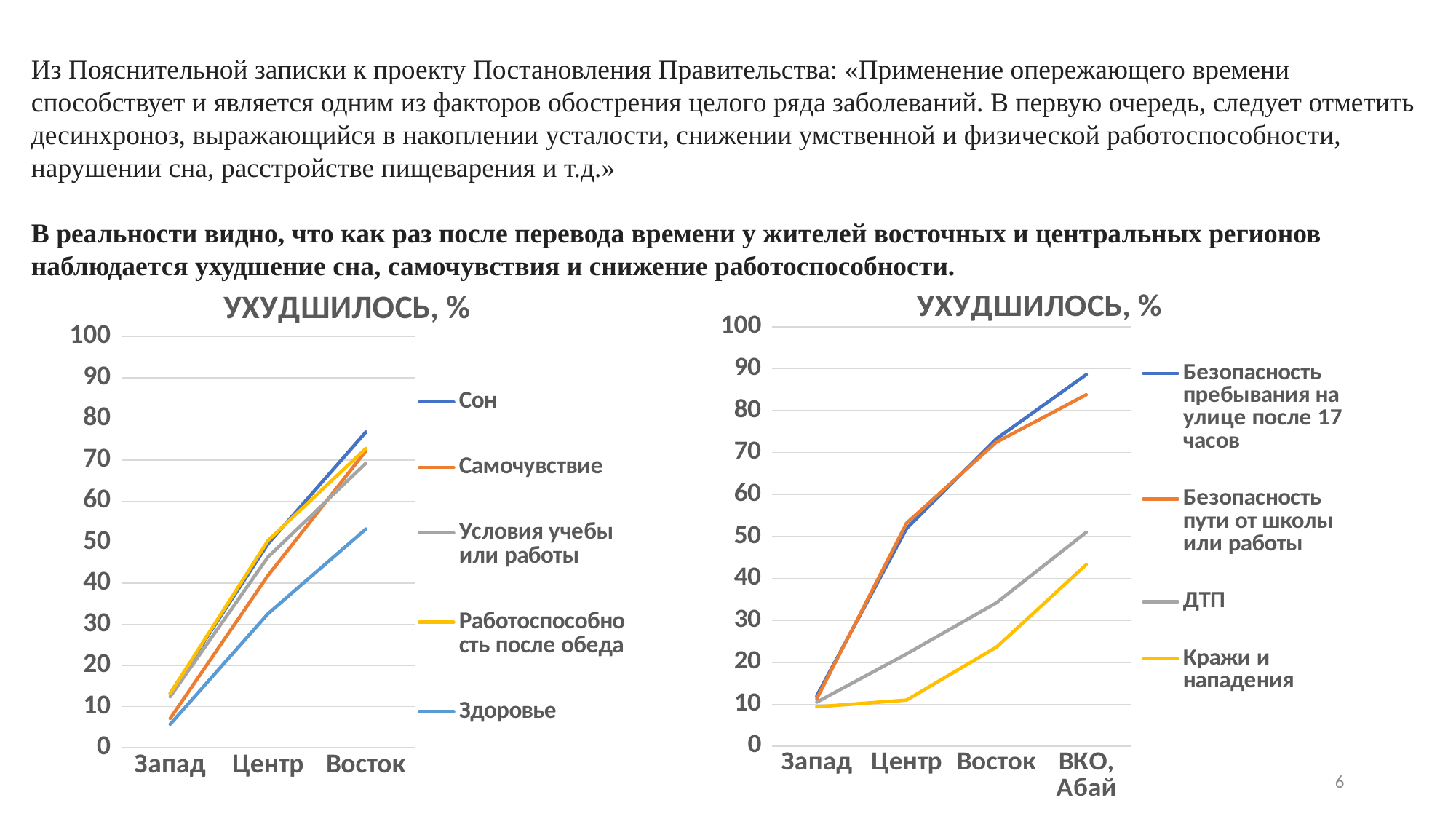
In the left chart, do the values for Здоровье rise or fall from Запад to Восток? rise In the right chart, which series has the lowest value at ВКО, Абай? Кражи и нападения In the right chart, which is larger at Центр: ДТП or Кражи и нападения? ДТП How many series does the legend of the left chart list? 5 In the left chart, is the value for Сон at Восток greater or less than 70? greater How many categories are on the x axis of the right chart? 4 In the right chart, is the value for ДТП at Восток greater or less than 40? less In the left chart, is the value for Здоровье at Восток greater or less than 60? less What kind of chart is the left chart on the slide? line chart What is the title of the right chart? УХУДШИЛОСЬ, % In the left chart, which series has the lowest value at Восток? Здоровье How many series does the legend of the right chart list? 4